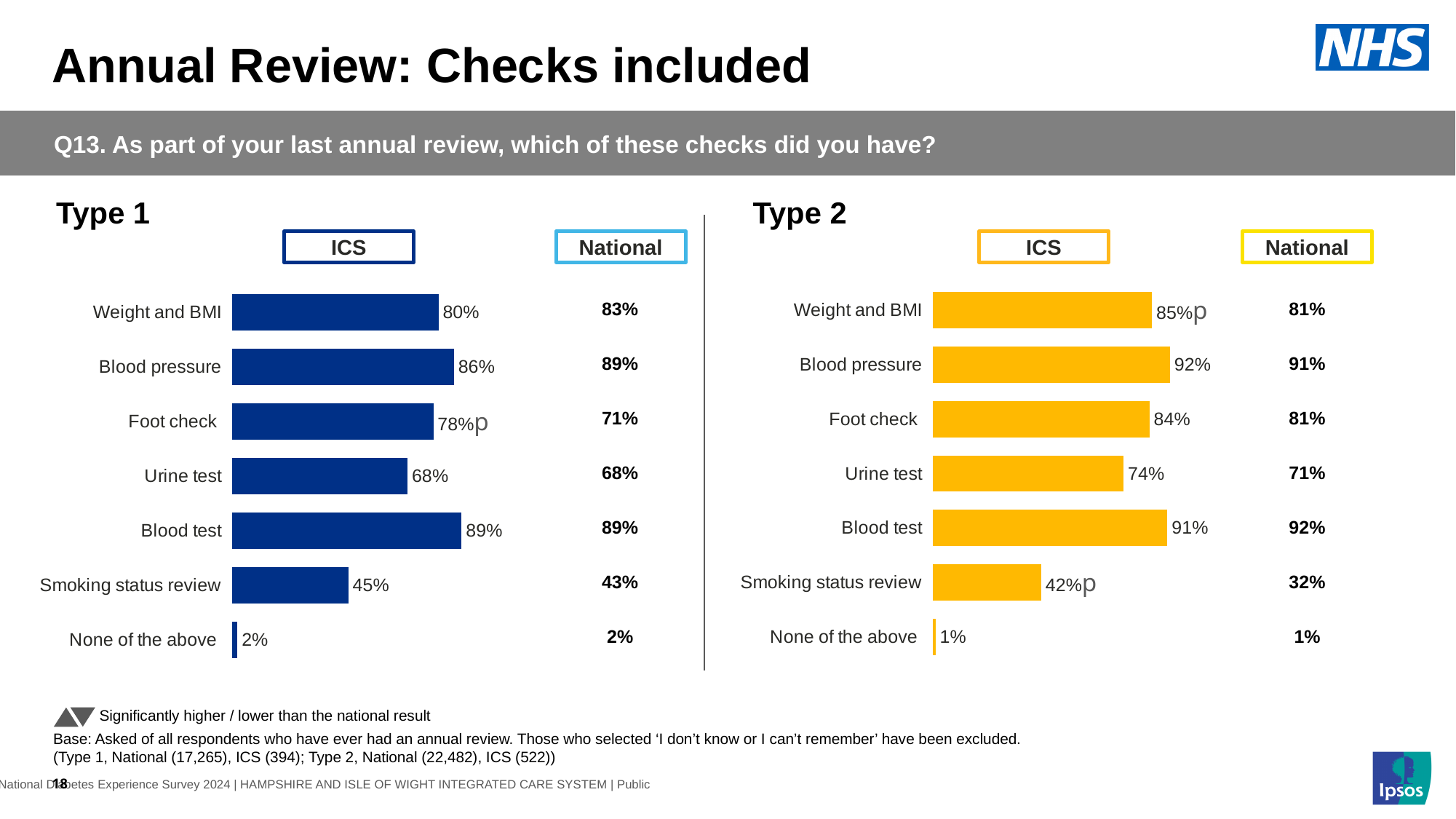
What colour are the bars in the Type 2 chart? Yellow In the Type 1 chart, is the ICS value for Weight and BMI higher or lower than the National value? lower In the Type 2 chart, what is the ICS value for Smoking status review? 42% In the Type 2 chart, is the ICS value for Urine test higher or lower than the National value? higher In the Type 1 chart, what is the ICS value for Blood pressure? 86% How many checks are listed in the Type 1 chart? 7 What type of chart is used to show the ICS results for Type 2? Bar chart In the Type 2 chart, what is the difference between the ICS and National values for Smoking status review? 10 percentage points In the Type 2 chart, which check has the highest ICS value? Blood pressure In the Type 1 chart, what is the National value for Foot check? 71% In the Type 1 chart, which check has the lowest ICS value? None of the above In the Type 1 chart, what is the difference between the ICS and National values for Foot check? 7 percentage points